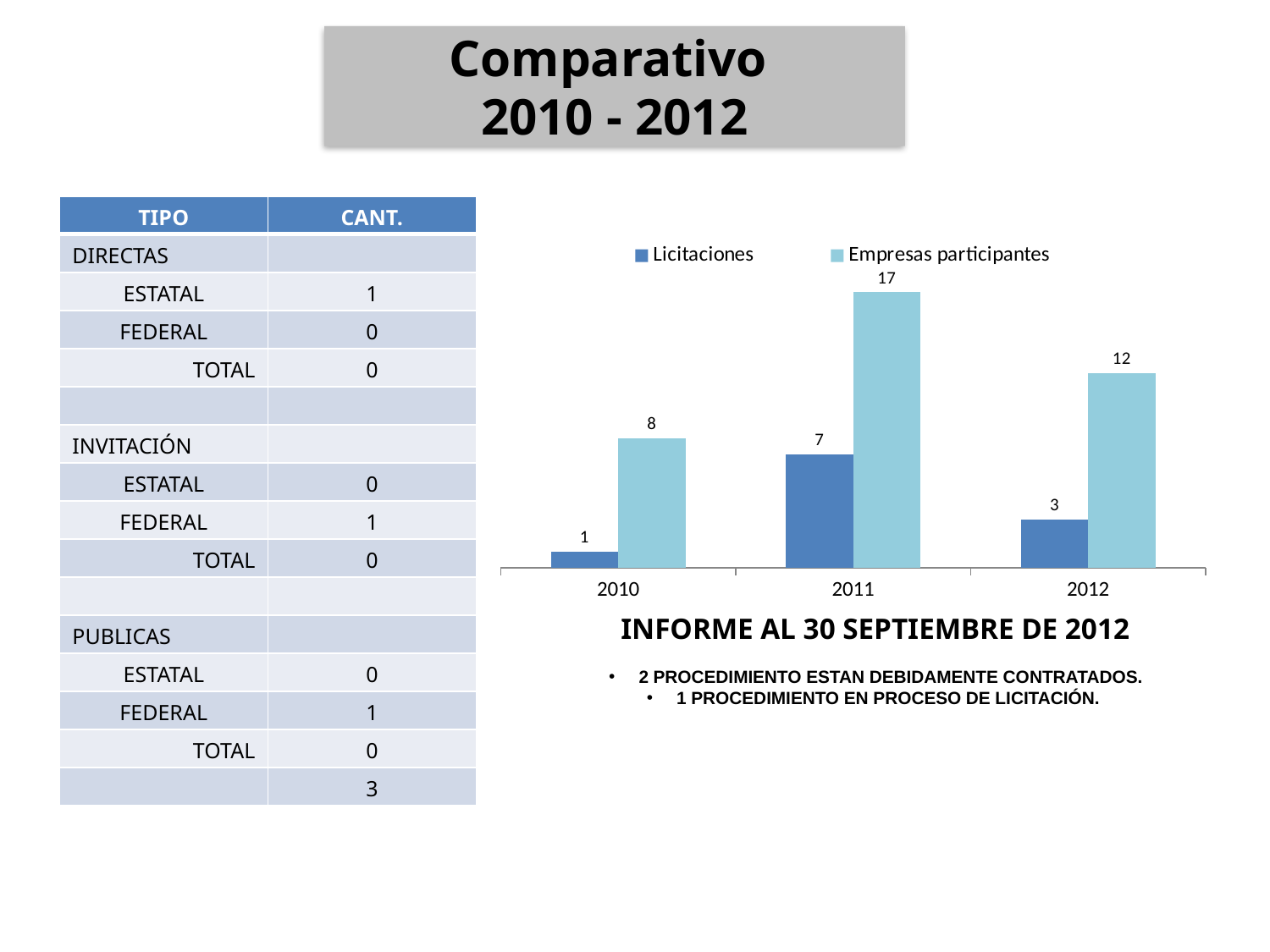
Which is larger: Licitaciones in 2012 or Licitaciones in 2011? Licitaciones in 2011 What kind of chart is shown on the slide? bar chart What is the difference between Licitaciones and Empresas participantes in 2010? 7 What is the value for Empresas participantes in 2010? 8 What are the two series named in the chart legend? Licitaciones and Empresas participantes Which year has the highest value for Empresas participantes? 2011 What is the value for Licitaciones in 2011? 7 What is the value for Empresas participantes in 2012? 12 How many series does the chart legend list? 2 How many years are shown on the x axis of the chart? 3 Which year has the lowest value for Licitaciones? 2010 What is the difference between Empresas participantes in 2011 and 2012? 5